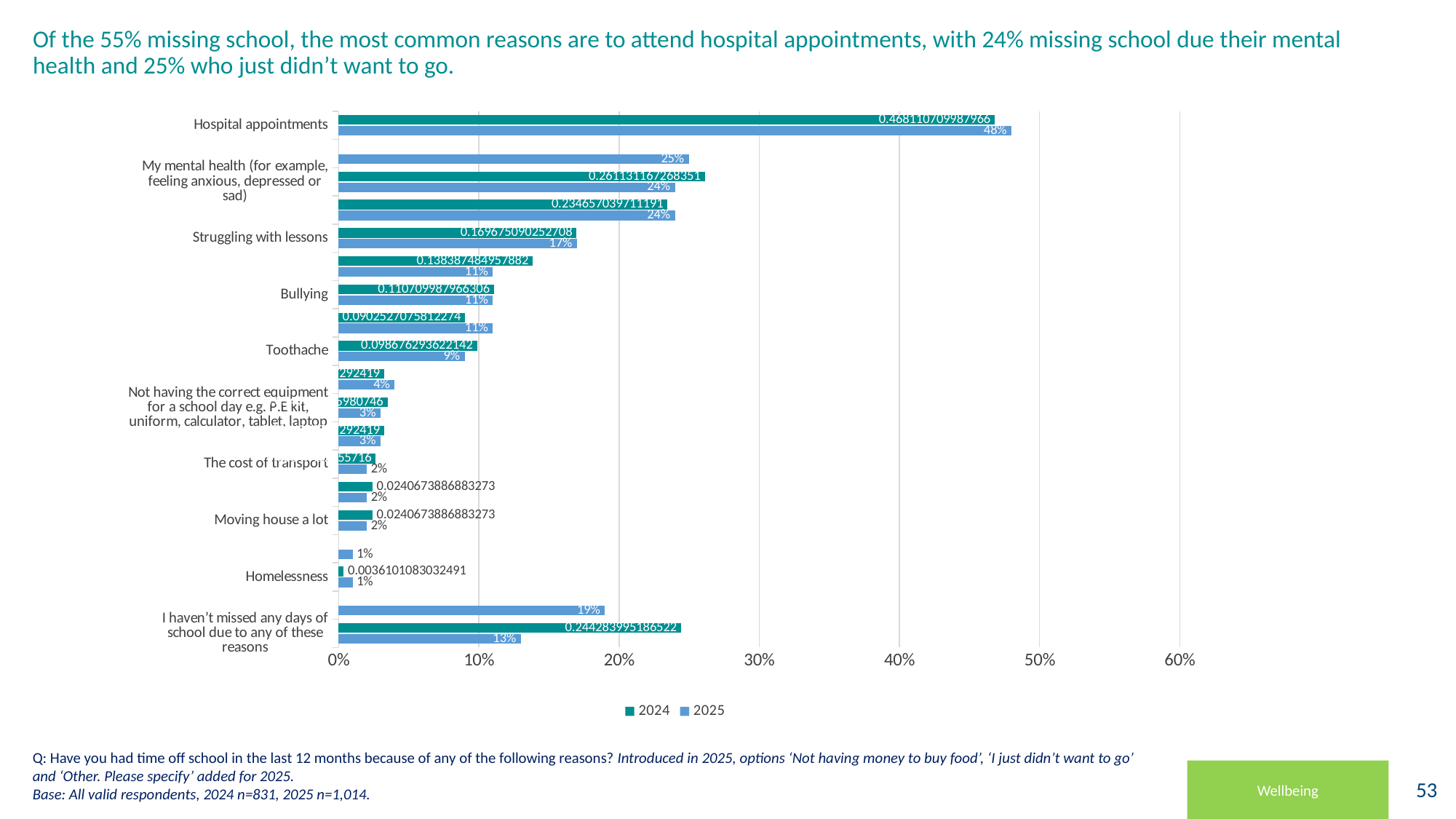
What kind of chart is shown on the slide? bar chart What are the two series named in the legend? 2024 and 2025 How many series does the legend list? 2 What is the difference between the 2025 values for Hospital appointments and Bullying? 37 percentage points What is the 2025 value for Struggling with lessons? 17% What is the 2025 value for Toothache? 9% Which reason has the highest value in 2025? Hospital appointments What is the 2024 value printed for Hospital appointments? 0.468110709987966 Is the 2025 value for Hospital appointments greater or less than 40%? greater What is the 2025 value for Hospital appointments? 48% Which is larger in 2025: Hospital appointments or Struggling with lessons? Hospital appointments What is the 2025 value for Bullying? 11%